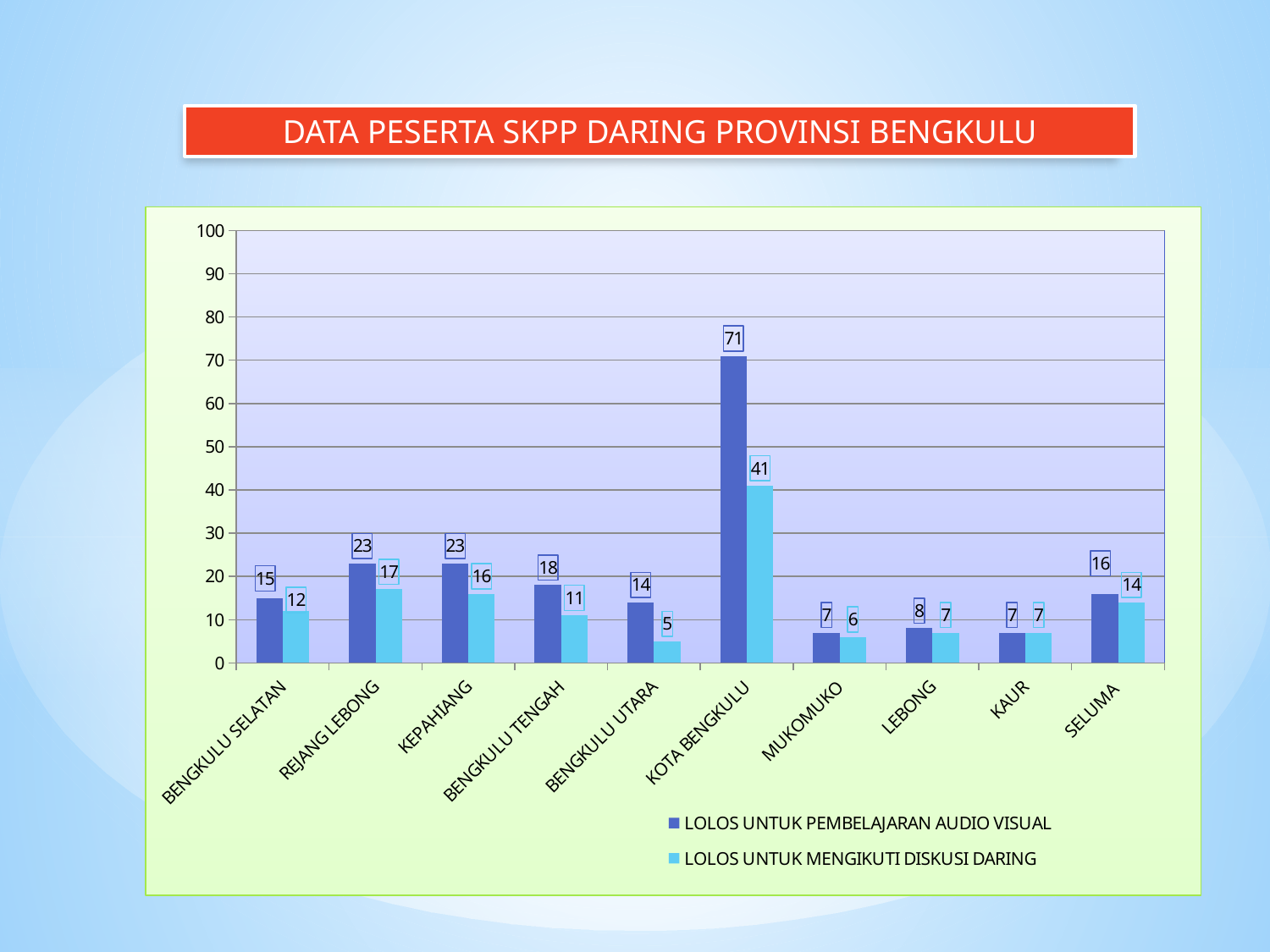
Which category has the lowest value in the LOLOS UNTUK MENGIKUTI DISKUSI DARING series? BENGKULU UTARA What is the value for SELUMA in the LOLOS UNTUK PEMBELAJARAN AUDIO VISUAL series? 16 How many series does the legend list? 2 Which is larger: the LOLOS UNTUK PEMBELAJARAN AUDIO VISUAL value for KEPAHIANG or for SELUMA? KEPAHIANG What is the value for BENGKULU UTARA in the LOLOS UNTUK MENGIKUTI DISKUSI DARING series? 5 What kind of chart is shown on the slide? bar chart Which category has the highest value in the LOLOS UNTUK MENGIKUTI DISKUSI DARING series? KOTA BENGKULU How many categories are shown on the x axis? 10 What is the difference between the LOLOS UNTUK PEMBELAJARAN AUDIO VISUAL and LOLOS UNTUK MENGIKUTI DISKUSI DARING values for KOTA BENGKULU? 30 What is the difference between the LOLOS UNTUK PEMBELAJARAN AUDIO VISUAL values for REJANG LEBONG and BENGKULU TENGAH? 5 What is the value for KOTA BENGKULU in the LOLOS UNTUK PEMBELAJARAN AUDIO VISUAL series? 71 Is the LOLOS UNTUK PEMBELAJARAN AUDIO VISUAL value for KOTA BENGKULU greater or less than 60? greater